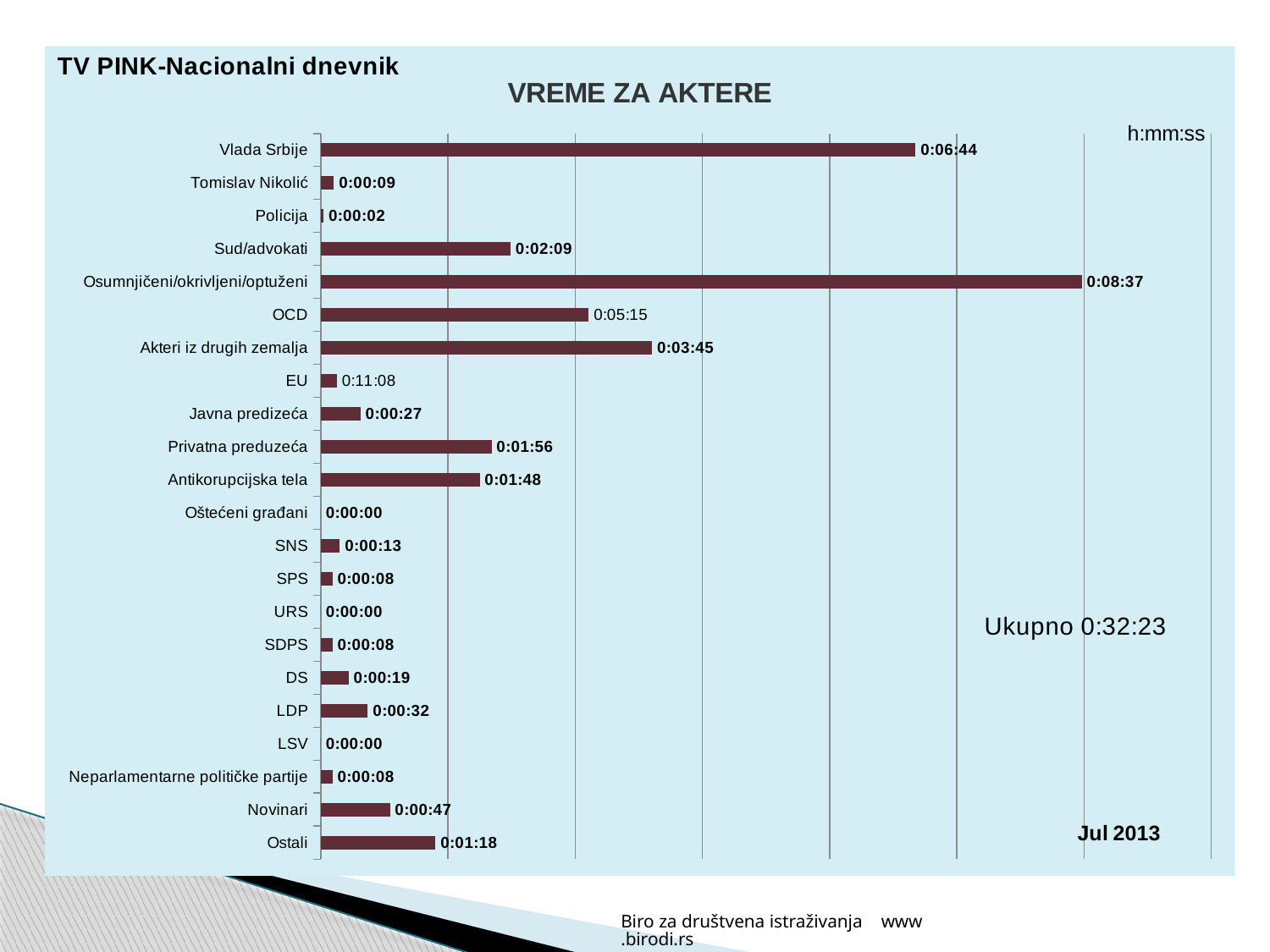
What is the value for Novinari? 0:00:47 How many categories have a value of 0:00:00? 3 What is the difference between the values for Vlada Srbije and Sud/advokati? 0:04:35 How many categories are shown on the chart? 22 What is the value for Vlada Srbije? 0:06:44 What is the value for Antikorupcijska tela? 0:01:48 What kind of chart is shown on the slide? Bar chart What is the difference between the values for Privatna preduzeća and Antikorupcijska tela? 0:00:08 What is the value for Osumnjičeni/okrivljeni/optuženi? 0:08:37 Which is larger, the value for LDP or the value for DS? LDP What total (Ukupno) is shown on the chart? 0:32:23